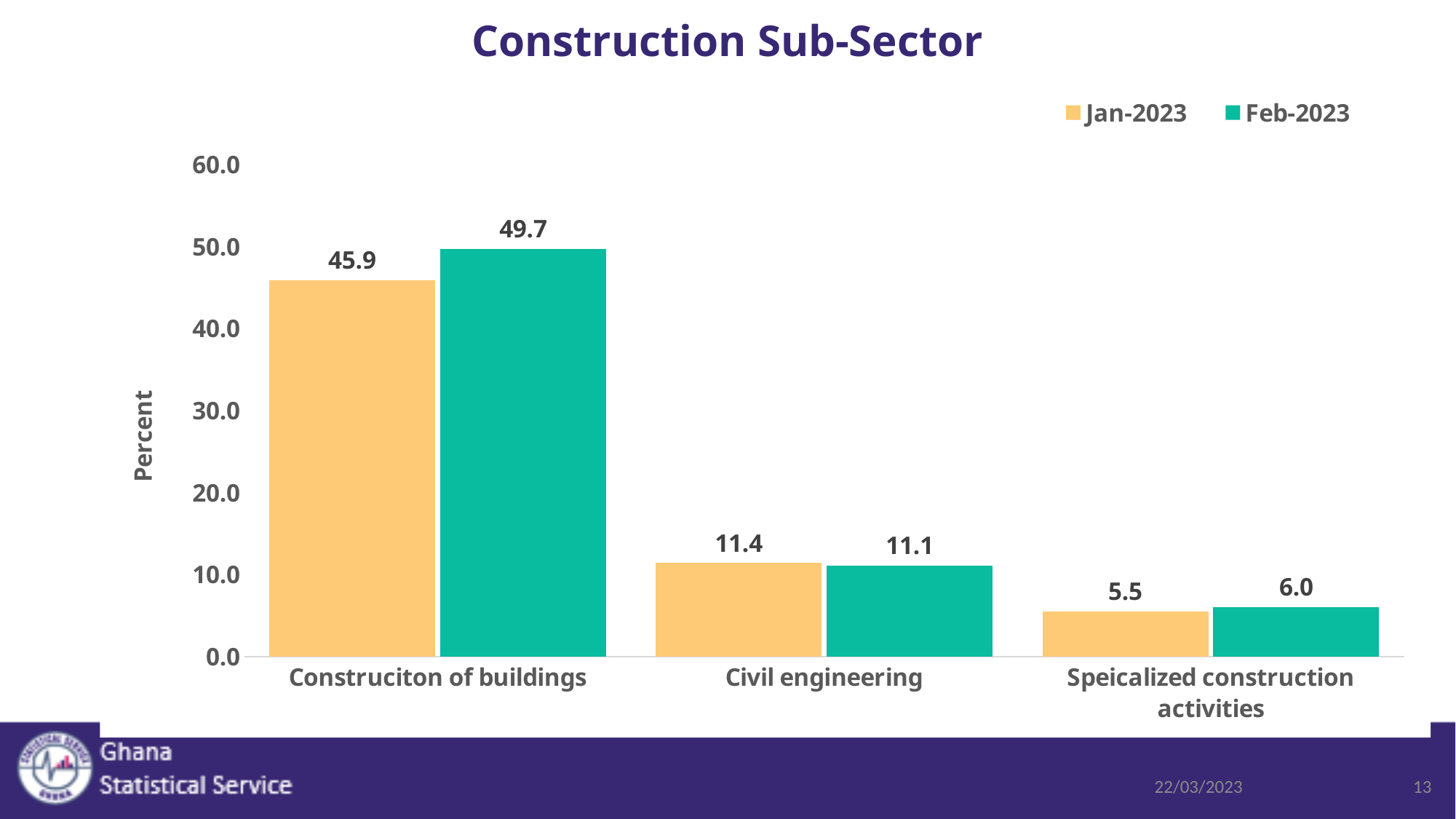
Which category has the lowest Jan-2023 value? Speicalized construction activities What is the Jan-2023 value for Speicalized construction activities? 5.5 What kind of chart is shown on the slide? bar chart How many series does the legend list? 2 How many categories are shown on the x axis? 3 What is the label of the vertical axis? Percent Which is larger for Civil engineering, the Jan-2023 value or the Feb-2023 value? Jan-2023 Which category has the highest Feb-2023 value? Construciton of buildings What is the Feb-2023 value for Construciton of buildings? 49.7 Is the Jan-2023 value for Construciton of buildings greater or less than 40.0? greater What is the Jan-2023 value for Civil engineering? 11.4 What is the difference between the Feb-2023 and Jan-2023 values for Construciton of buildings? 3.8